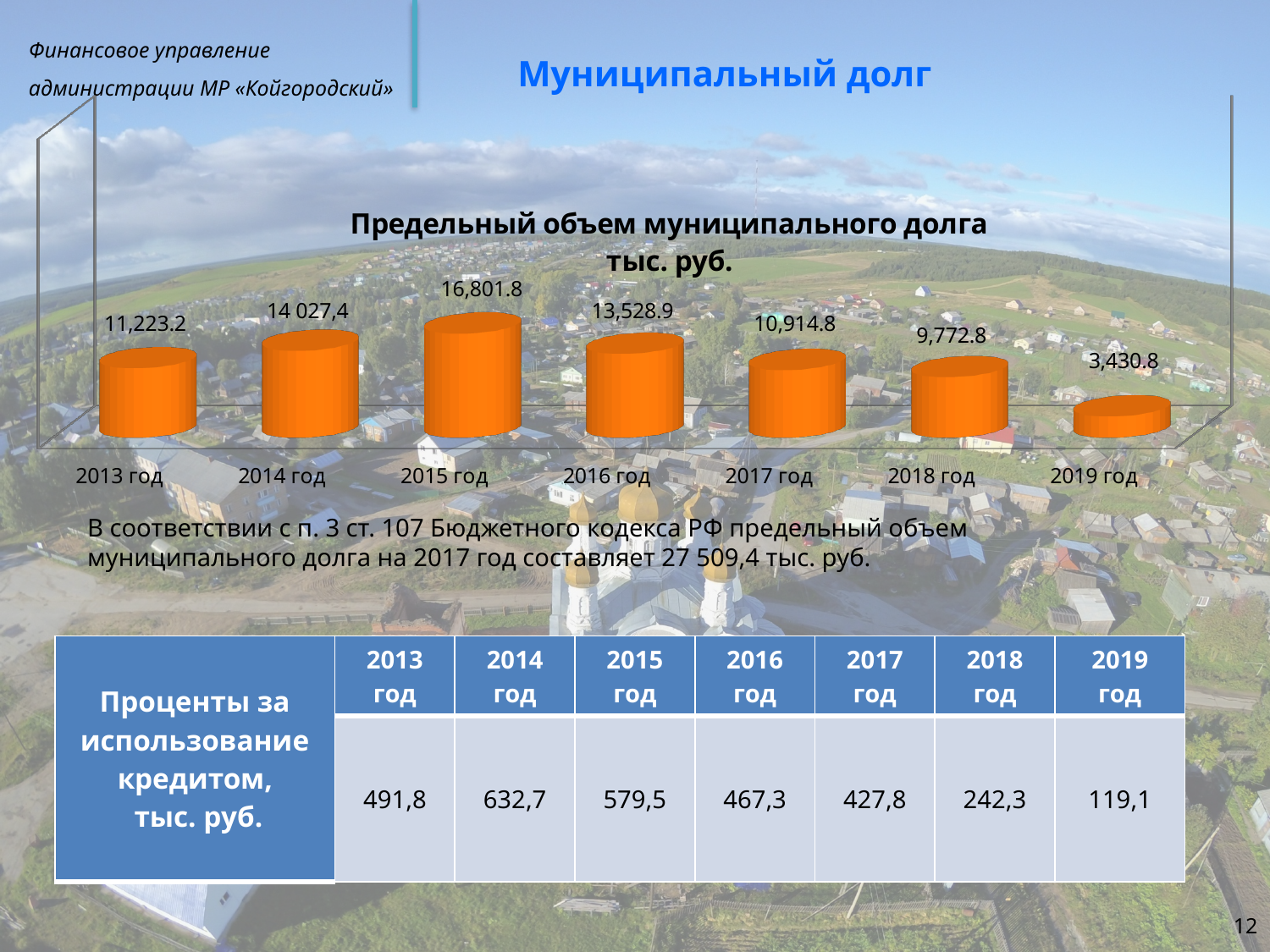
What is the value for 2018 год in the chart? 9,772.8 What is the value for 2014 год in the chart? 14 027,4 What is the value for 2015 год in the chart? 16,801.8 What is the value for 2019 год in the chart? 3,430.8 What kind of chart is shown on the slide? bar chart How many years are shown in the chart? 7 Which year has the lowest value in the chart? 2019 год Which is larger, the value for 2017 год or the value for 2018 год? 2017 год What is the difference between the values for 2015 год and 2019 год? 13,371.0 From 2015 год to 2019 год, do the values in the chart rise or fall? fall Which year has the highest value in the chart? 2015 год What is the difference between the values for 2016 год and 2018 год? 3,756.1